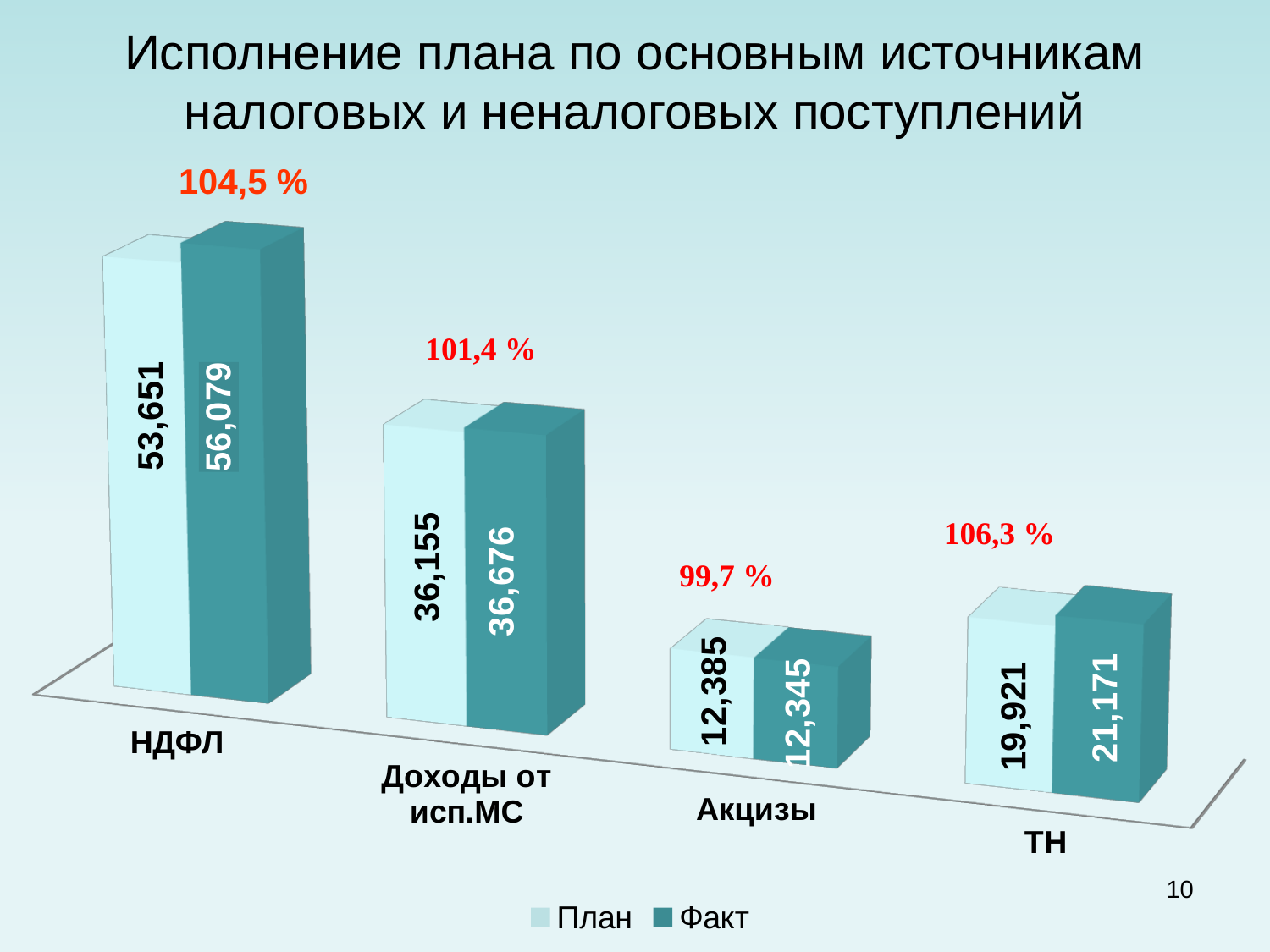
What is the Факт value for ТН? 21,171 How many series does the legend list? 2 What is the difference between the Факт and План values for ТН? 1,250 Which category has the highest Факт value? НДФЛ What is the План value for НДФЛ? 53,651 Which category has the lowest План value? Акцизы Which is larger for ТН, the План value or the Факт value? Факт What is the План value for Акцизы? 12,385 What is the Факт value for Доходы от исп.МС? 36,676 How many categories are shown on the x axis? 4 What is the difference between the Факт and План values for НДФЛ? 2,428 What percentage of plan execution is shown above the Акцизы bars? 99,7 %